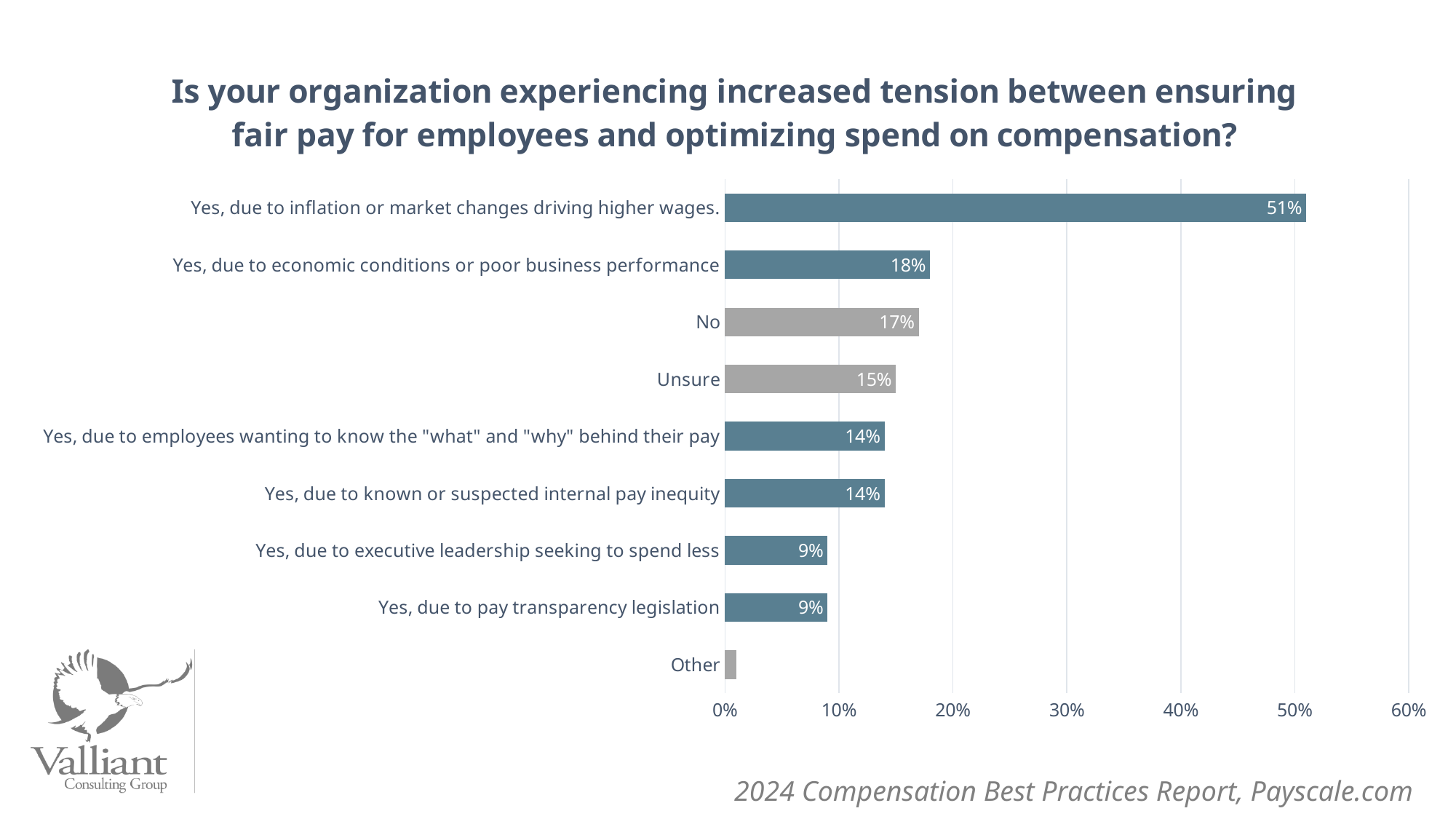
Which category has the lowest value? Other How many categories are shown in the chart? 9 Which category has the highest value? Yes, due to inflation or market changes driving higher wages. What is the value for "Unsure"? 15% What is the value for "Yes, due to economic conditions or poor business performance"? 18% What is the value for "Yes, due to pay transparency legislation"? 9% What is the difference between the value for "Yes, due to inflation or market changes driving higher wages" and the value for "No"? 34% Which is larger: the value for "No" or the value for "Unsure"? No Is the value for "Other" greater or less than 10%? less What percentage of respondents answered "No"? 17% What kind of chart is shown on the slide? Bar chart What percentage of respondents said yes due to inflation or market changes driving higher wages? 51%